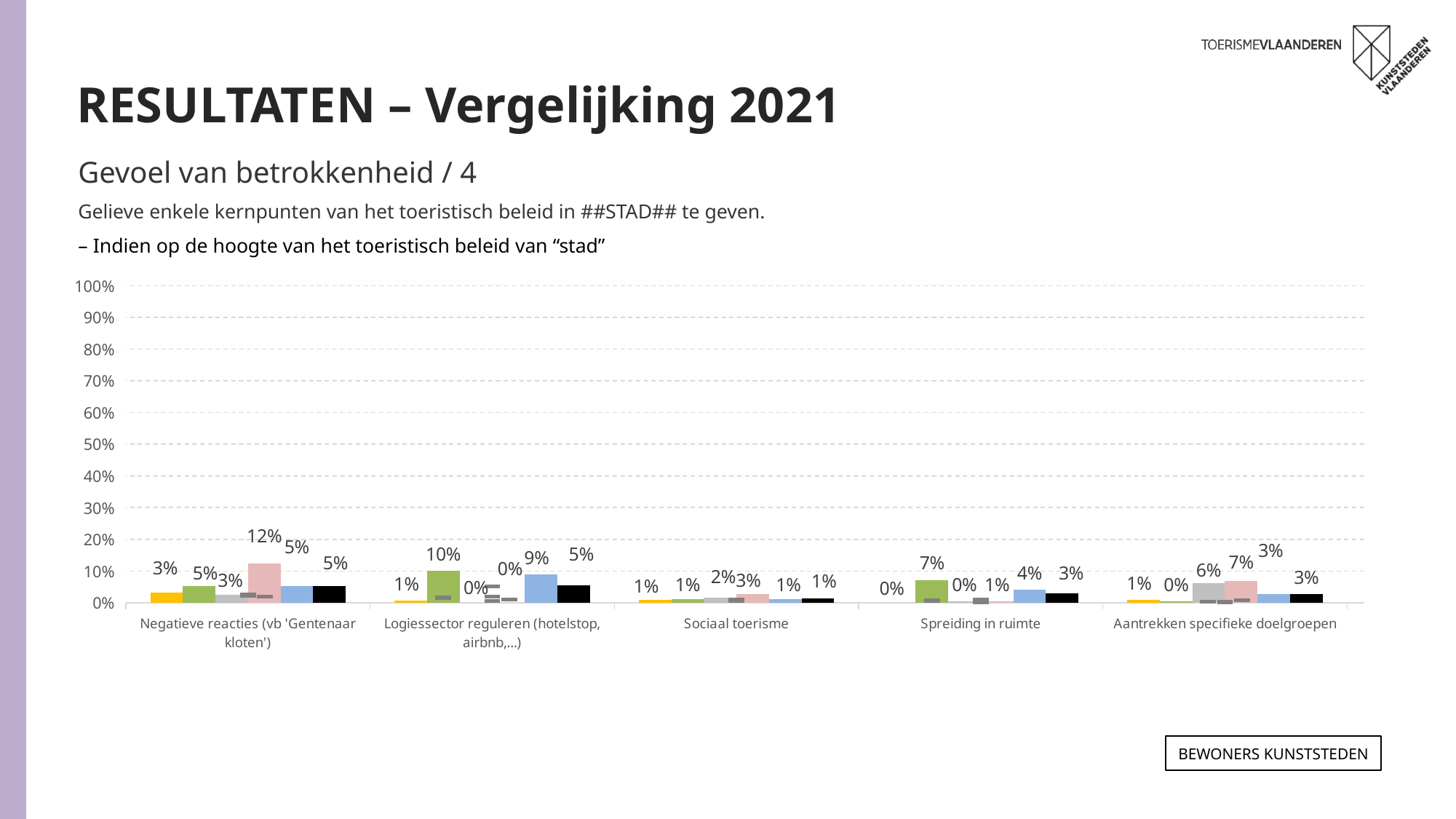
What is the difference between the pink bar (12%) and the green bar (5%) for 'Negatieve reacties (vb 'Gentenaar kloten')'? 7 percentage points Is the value of the pink bar for 'Negatieve reacties (vb 'Gentenaar kloten')' greater or less than 20%? less What is the value of the blue bar for 'Logiessector reguleren (hotelstop, airbnb,...)'? 9% What is the highest value shown on the y axis of the chart? 100% Which is larger: the green bar for 'Logiessector reguleren (hotelstop, airbnb,...)' or the green bar for 'Spreiding in ruimte'? Logiessector reguleren (hotelstop, airbnb,...) What kind of chart is shown on the slide? bar chart What is the value of the pink bar for 'Negatieve reacties (vb 'Gentenaar kloten')'? 12% What is the value of the green bar for 'Spreiding in ruimte'? 7% Which category contains the bar labelled 12%? Negatieve reacties (vb 'Gentenaar kloten') What is the value of the green bar for 'Logiessector reguleren (hotelstop, airbnb,...)'? 10% How many categories are shown along the x axis of the chart? 5 What is the highest data label shown anywhere on the chart? 12%